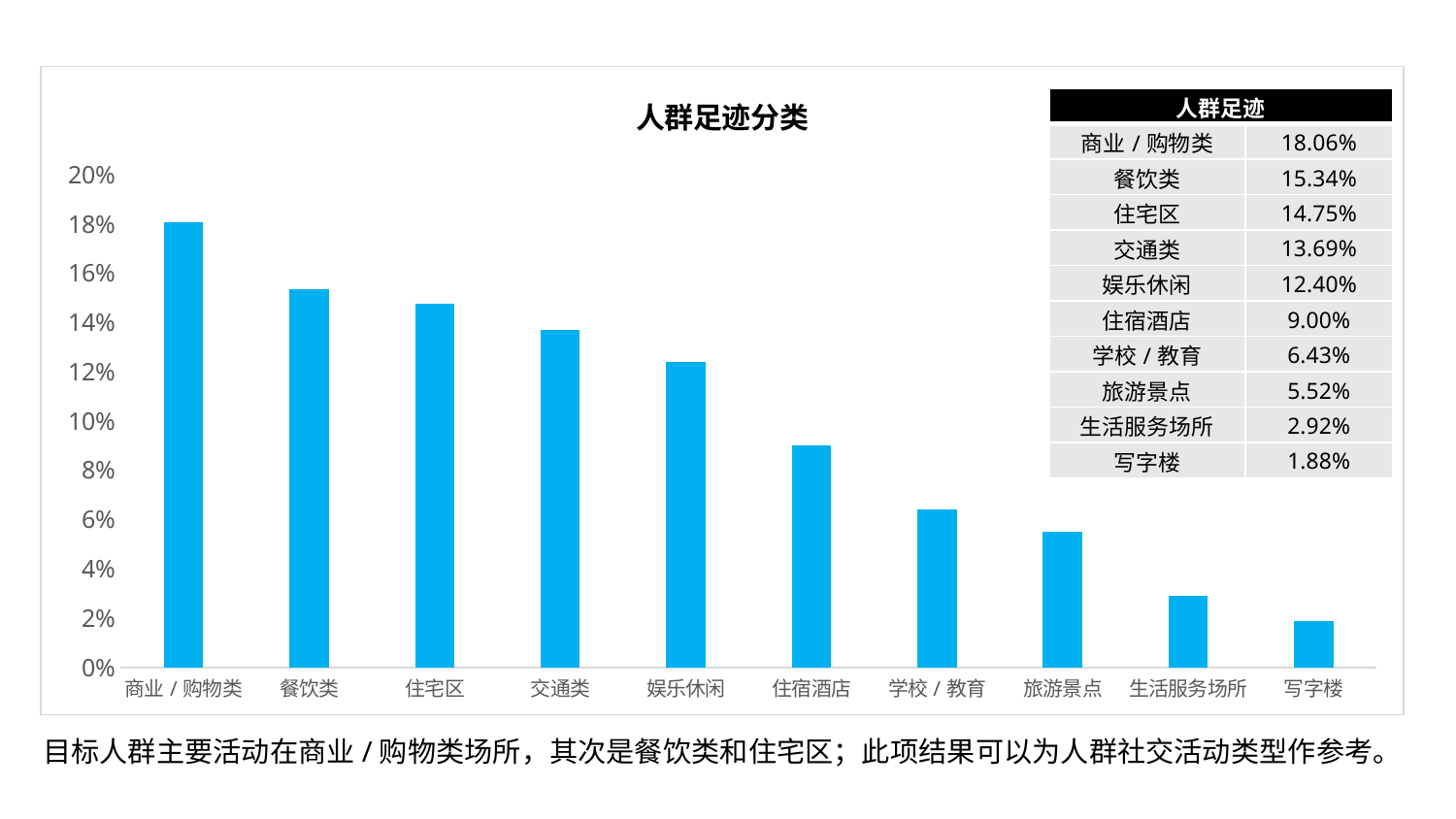
What is the value for 生活服务场所? 2.92% How many categories are plotted in the chart? 10 What is the value for 餐饮类? 15.34% Which category has the lowest value in the chart? 写字楼 What kind of chart is shown on the slide? bar chart Which is larger, the value for 交通类 or the value for 娱乐休闲? 交通类 Which category has the highest value in the chart? 商业 / 购物类 What is the value for 住宿酒店? 9.00% Is the value for 学校 / 教育 greater or less than 8%? less Do the values rise or fall from left to right along the x axis? fall What is the difference between the values for 商业 / 购物类 and 餐饮类? 2.72% What is the title of the chart? 人群足迹分类